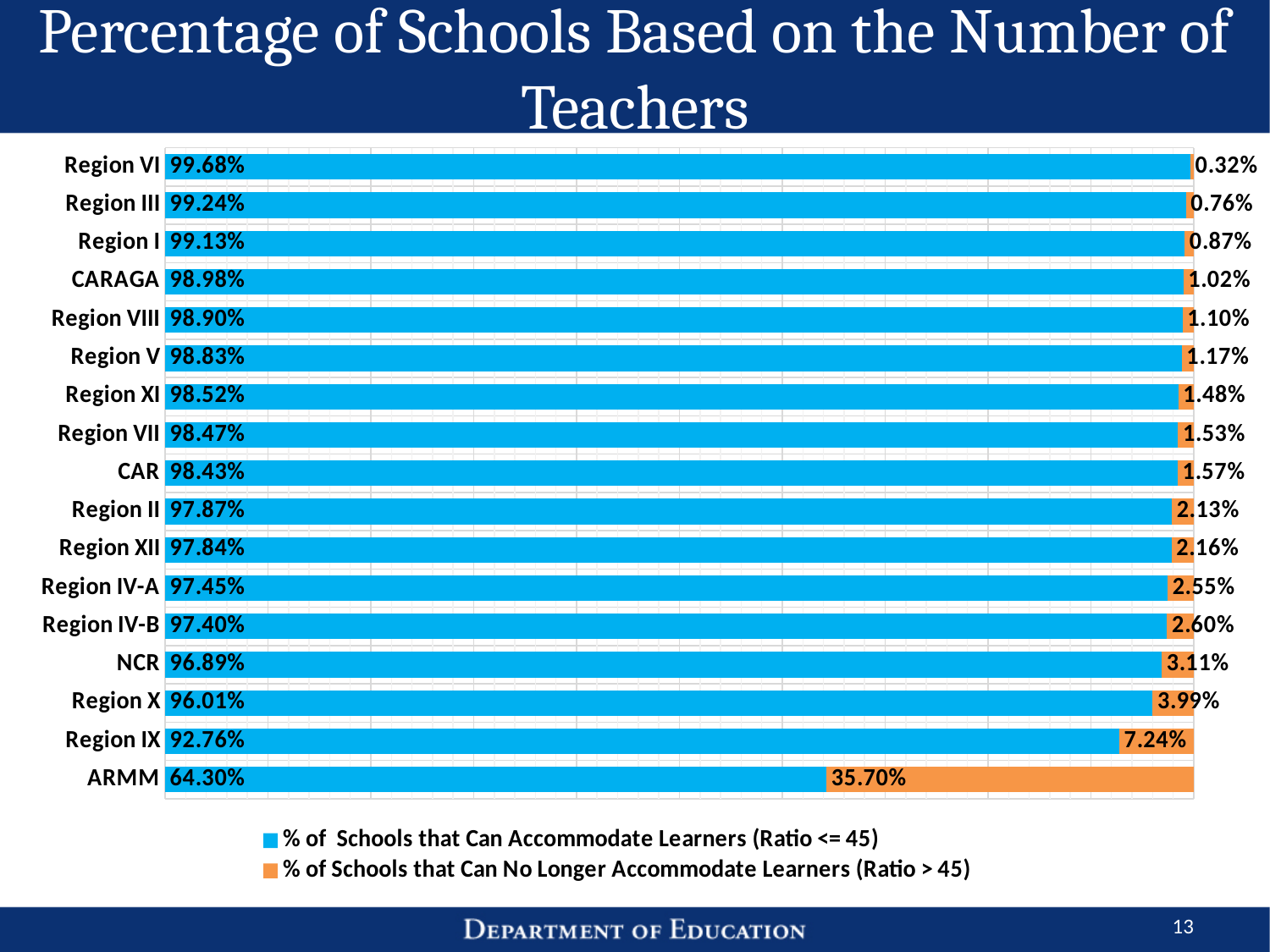
Which has a higher percentage of schools that can accommodate learners, CAR or NCR? CAR What is the percentage of schools that can no longer accommodate learners in ARMM? 35.70% Which region has the lowest percentage of schools that can accommodate learners? ARMM Which series is shown in blue in the legend? % of Schools that Can Accommodate Learners (Ratio <= 45) How many series does the legend list? 2 How many regions are plotted in the chart? 17 What type of chart is shown on the slide? Stacked bar chart What is the difference between the percentage of schools that can no longer accommodate learners in Region IX and in Region X? 3.25% What is the percentage of schools that can accommodate learners in Region VI? 99.68% What is the percentage of schools that can accommodate learners in NCR? 96.89% Which region has the highest percentage of schools that can accommodate learners? Region VI What is the total of the two segments of the ARMM bar? 100%